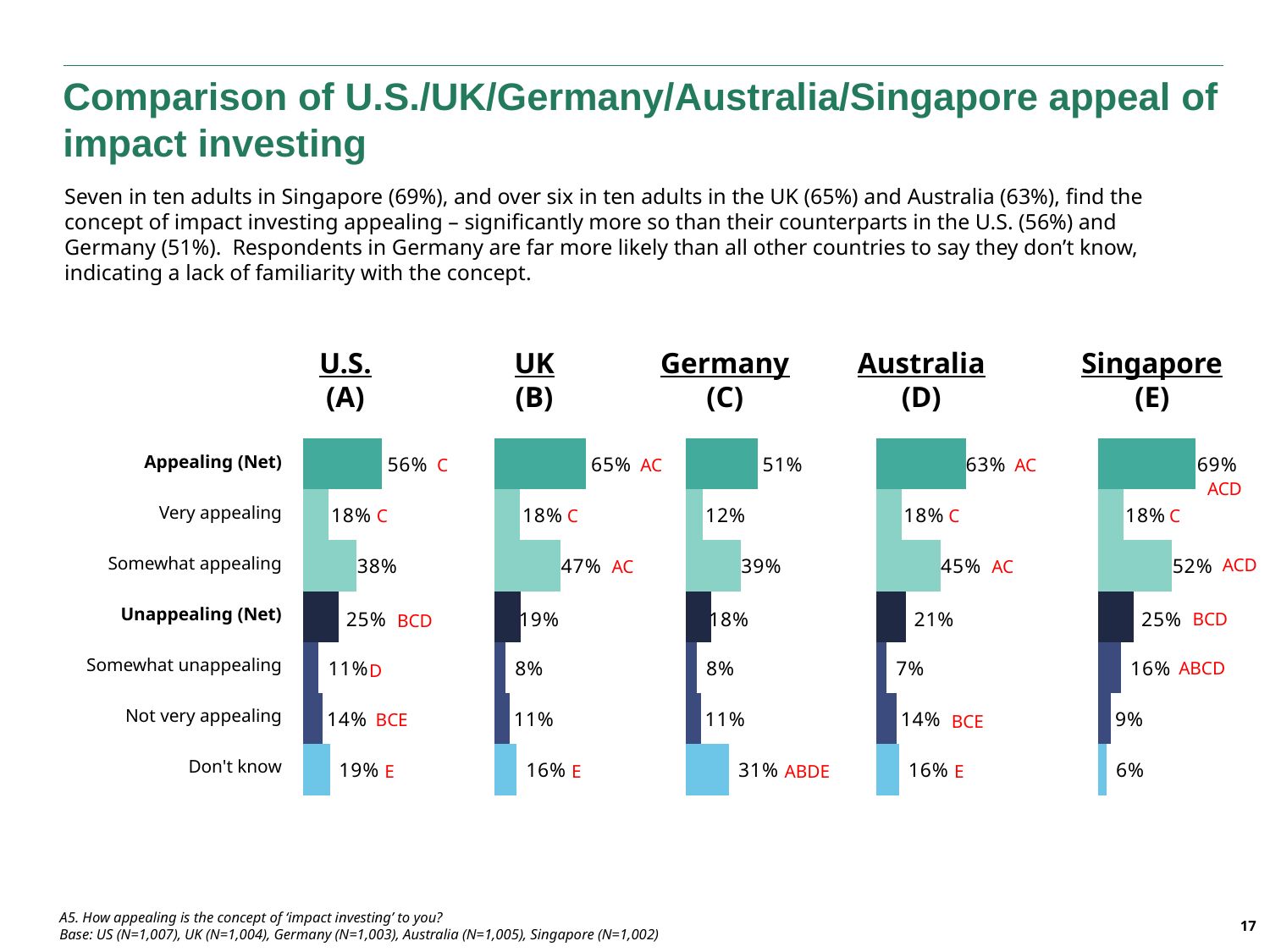
What kind of chart is used for each country on this slide? Bar chart How many country charts are shown on the slide? 5 In the UK (B) chart, which category has the highest value? Appealing (Net) In the Singapore (E) chart, what is the value for Somewhat appealing? 52% In the U.S. (A) chart, what is the value for Appealing (Net)? 56% In the Singapore (E) chart, which category has the lowest value? Don't know In the UK (B) chart, what is the difference between Appealing (Net) and Unappealing (Net)? 46% Which is larger: Appealing (Net) in the Singapore (E) chart or Appealing (Net) in the Germany (C) chart? Singapore (E) In the Germany (C) chart, what is the difference between Somewhat appealing and Very appealing? 27% How many categories are shown in the U.S. (A) chart? 7 In the Germany (C) chart, what is the value for Don't know? 31% In the Australia (D) chart, what is the value for Not very appealing? 14%